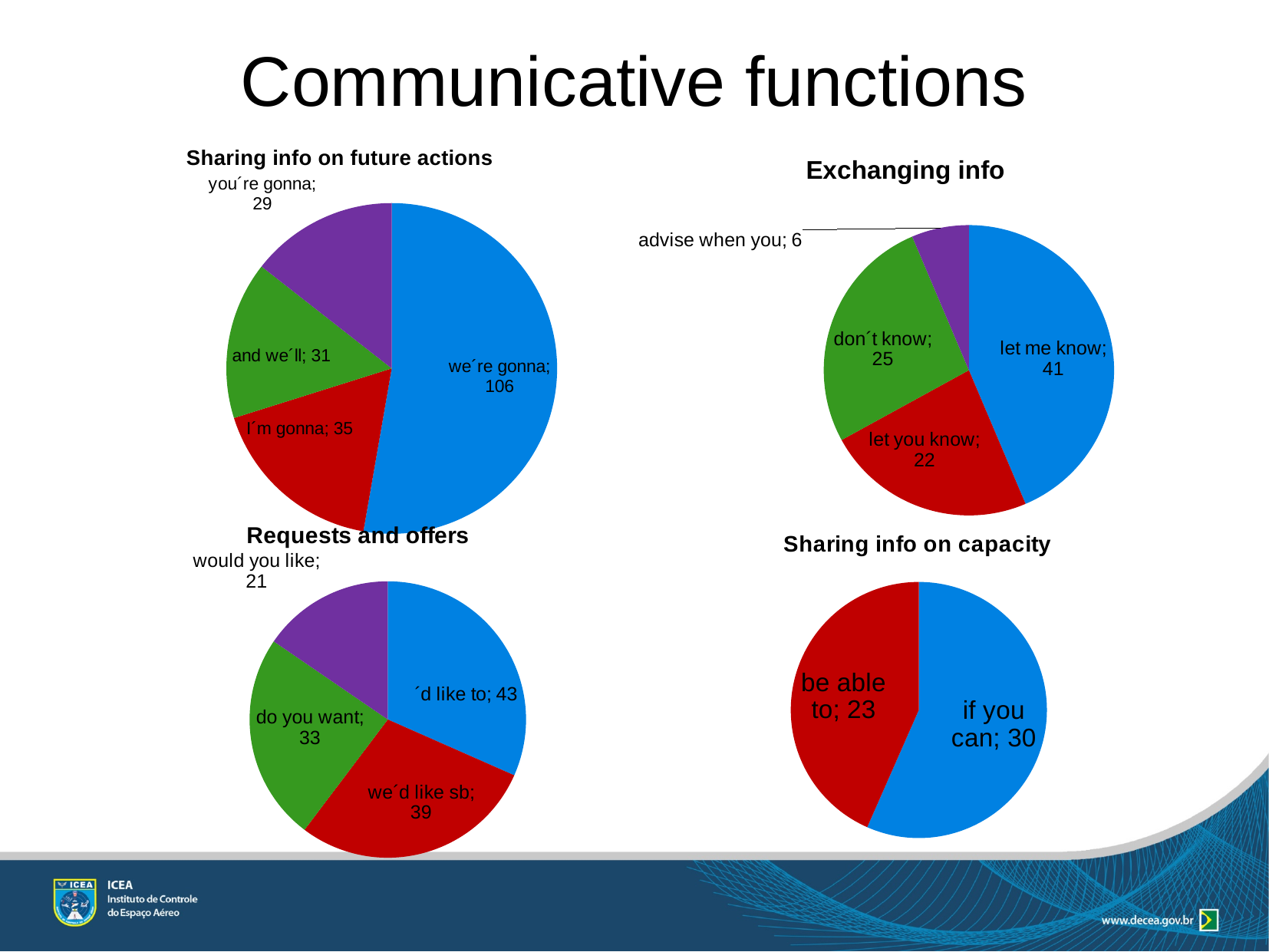
In the 'Exchanging info' chart, which category has the lowest value? advise when you How many charts are shown on the slide? 4 In the 'Requests and offers' chart, which category has the lowest value? would you like In the 'Sharing info on capacity' chart, what is the difference between 'if you can' and 'be able to'? 7 How many categories does the 'Requests and offers' chart have? 4 In the 'Exchanging info' chart, what is the value for 'let you know'? 22 In the 'Sharing info on future actions' chart, what is the value for 'we´re gonna'? 106 In the 'Requests and offers' chart, what is the value for 'do you want'? 33 In the 'Exchanging info' chart, which is larger: 'don´t know' or 'let you know'? don´t know In the 'Sharing info on future actions' chart, what is the difference between 'we´re gonna' and 'I´m gonna'? 71 In the 'Sharing info on capacity' chart, which category has the highest value? if you can What kind of chart is 'Sharing info on capacity'? pie chart